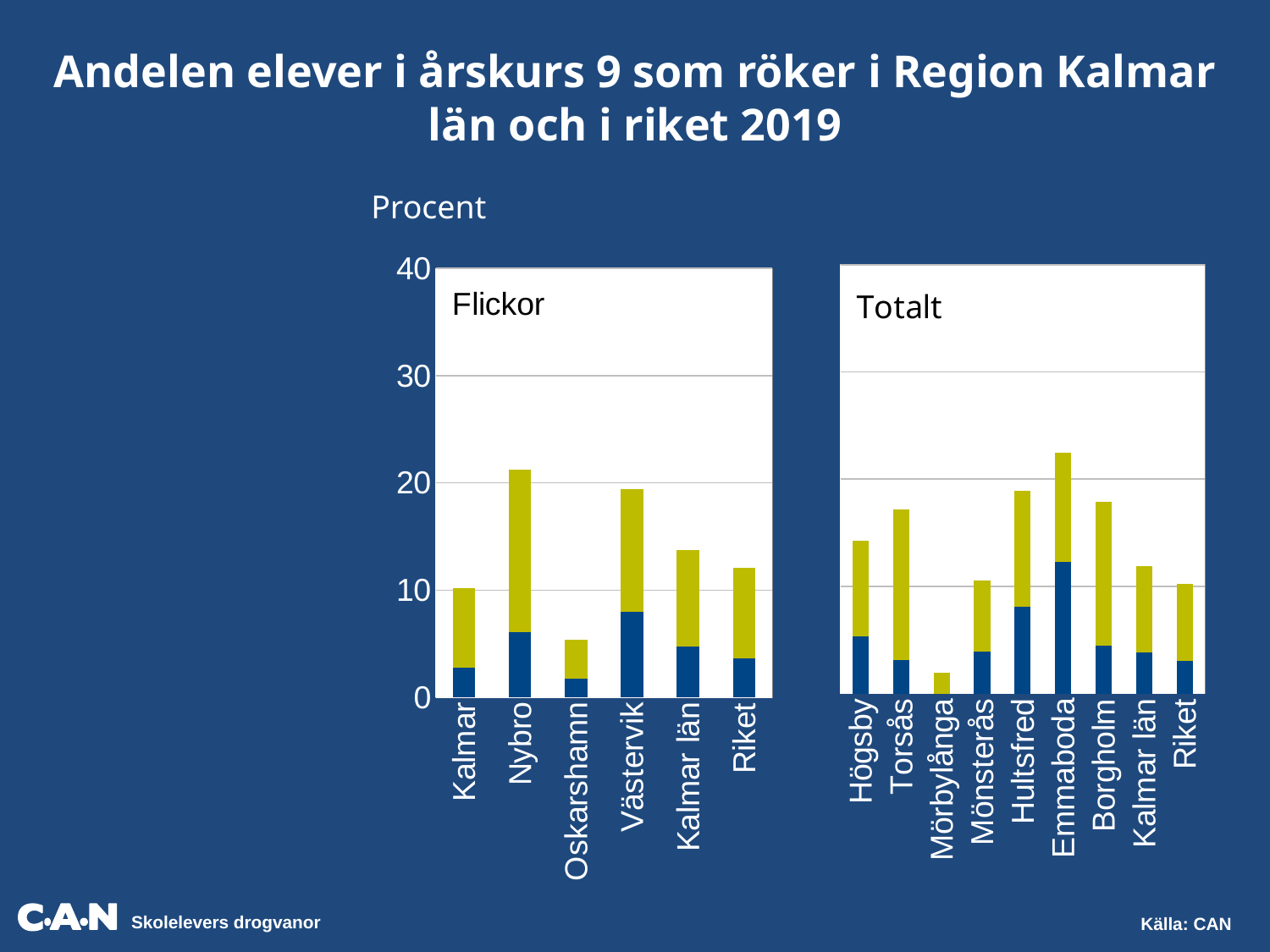
In the "Totalt" chart, is the total value for Emmaboda greater or less than 20? greater What kind of chart is the "Flickor" chart? bar chart In the "Totalt" chart, which category has the lowest bar? Mörbylånga In the "Flickor" chart, is the total value for Oskarshamn greater or less than 10? less In the "Totalt" chart, which is larger, the bar for Hultsfred or the bar for Mönsterås? Hultsfred In the "Flickor" chart, which category has the lowest bar? Oskarshamn In the "Flickor" chart, which is larger, the bar for Kalmar län or the bar for Riket? Kalmar län In the "Flickor" chart, which category has the highest bar? Nybro In the "Totalt" chart, which category has the highest bar? Emmaboda What unit label is shown above the y axis of the charts? Procent How many categories are shown on the x axis of the "Totalt" chart? 9 How many categories are shown on the x axis of the "Flickor" chart? 6